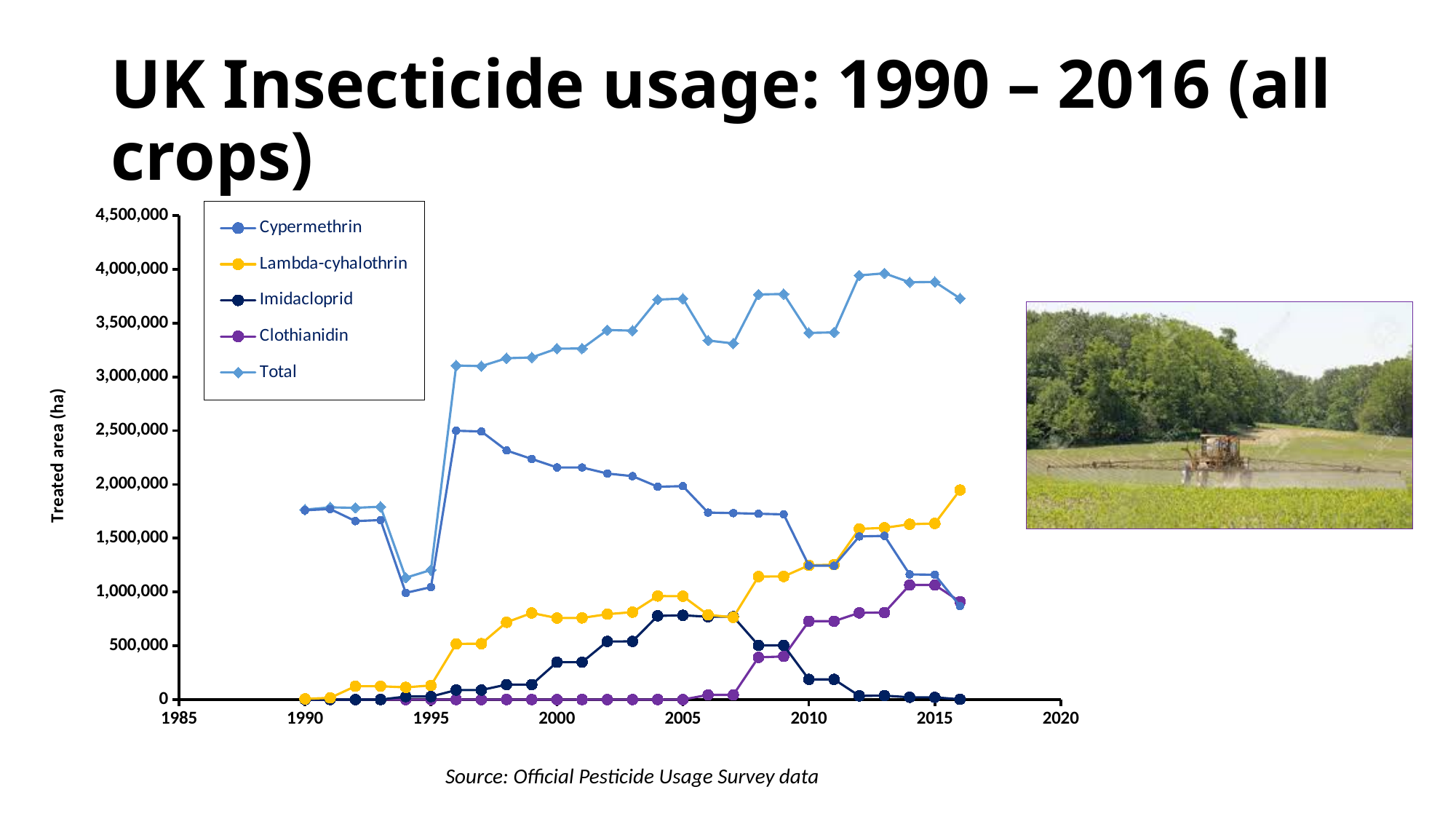
What source is cited below the chart? Official Pesticide Usage Survey data Is the value for Total in 2016 greater or less than 3,500,000? greater How many series does the legend list? 5 Which series has the lowest value in 2016? Imidacloprid What kind of chart is shown on the slide? Line chart Is the value for Imidacloprid in 2016 greater or less than 500,000? less Does the Cypermethrin line rise or fall from 1996 to 2016? Falls In 2000, which is larger: Cypermethrin or Lambda-cyhalothrin? Cypermethrin What is the label on the vertical axis? Treated area (ha) In 2016, which is larger: Lambda-cyhalothrin or Cypermethrin? Lambda-cyhalothrin Is the value for Lambda-cyhalothrin in 2016 greater or less than 1,500,000? greater